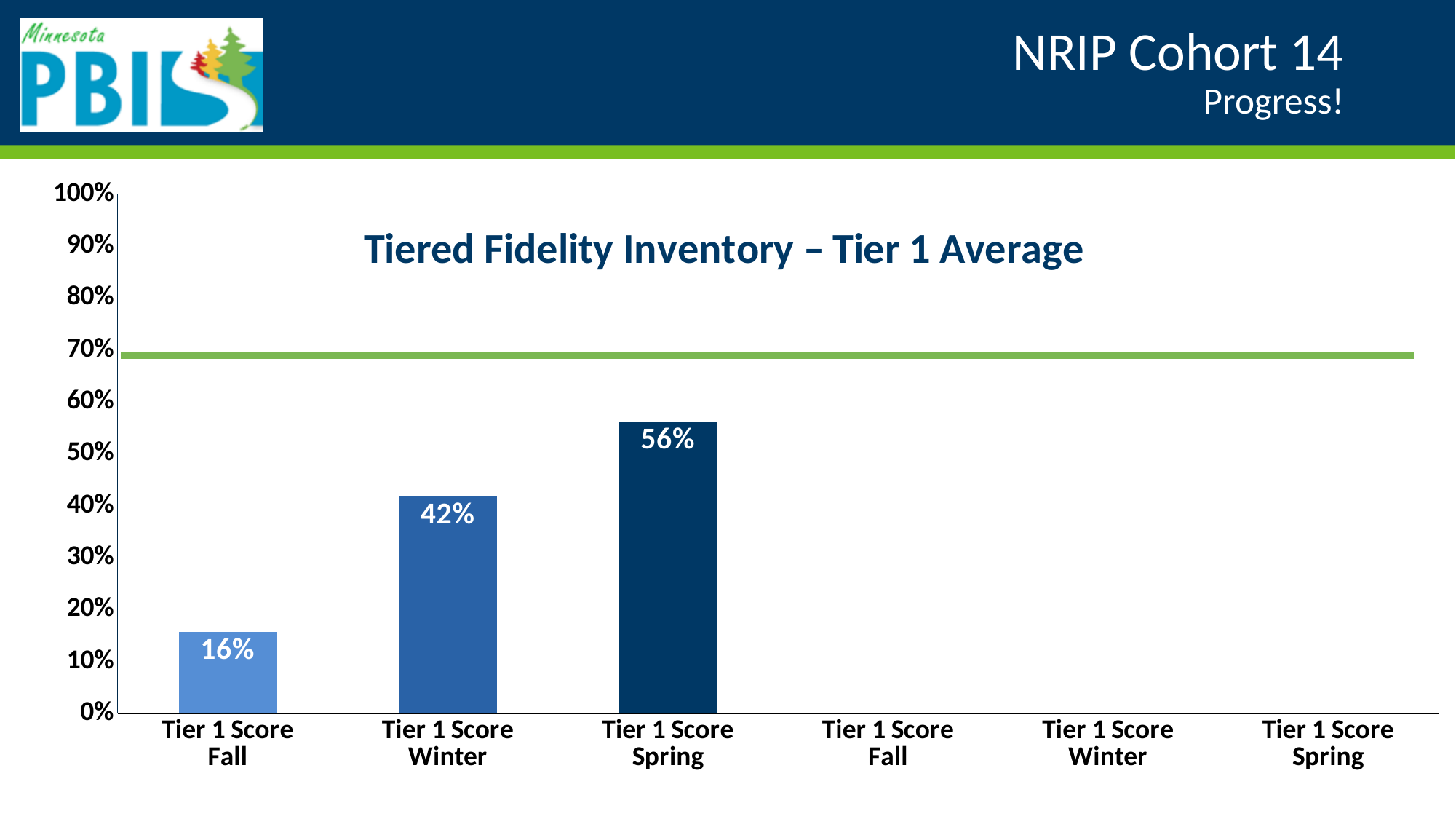
Which plotted bar has the highest value? Tier 1 Score Spring Do the plotted values rise or fall from Fall to Spring? Rise Is the value for Tier 1 Score Spring greater or less than 70%? less What is the difference between the Tier 1 Score Winter value and the Tier 1 Score Fall value? 26 percentage points What is the value of the leftmost bar, Tier 1 Score Fall? 16% Which plotted bar has the lowest value? Tier 1 Score Fall What is the value of the Tier 1 Score Spring bar? 56% What type of chart is shown on the slide? Bar chart What is the difference between the Tier 1 Score Spring value and the Tier 1 Score Winter value? 14 percentage points What is the title of the chart? Tiered Fidelity Inventory – Tier 1 Average What is the value of the Tier 1 Score Winter bar? 42% How many bars are plotted on the chart? 3